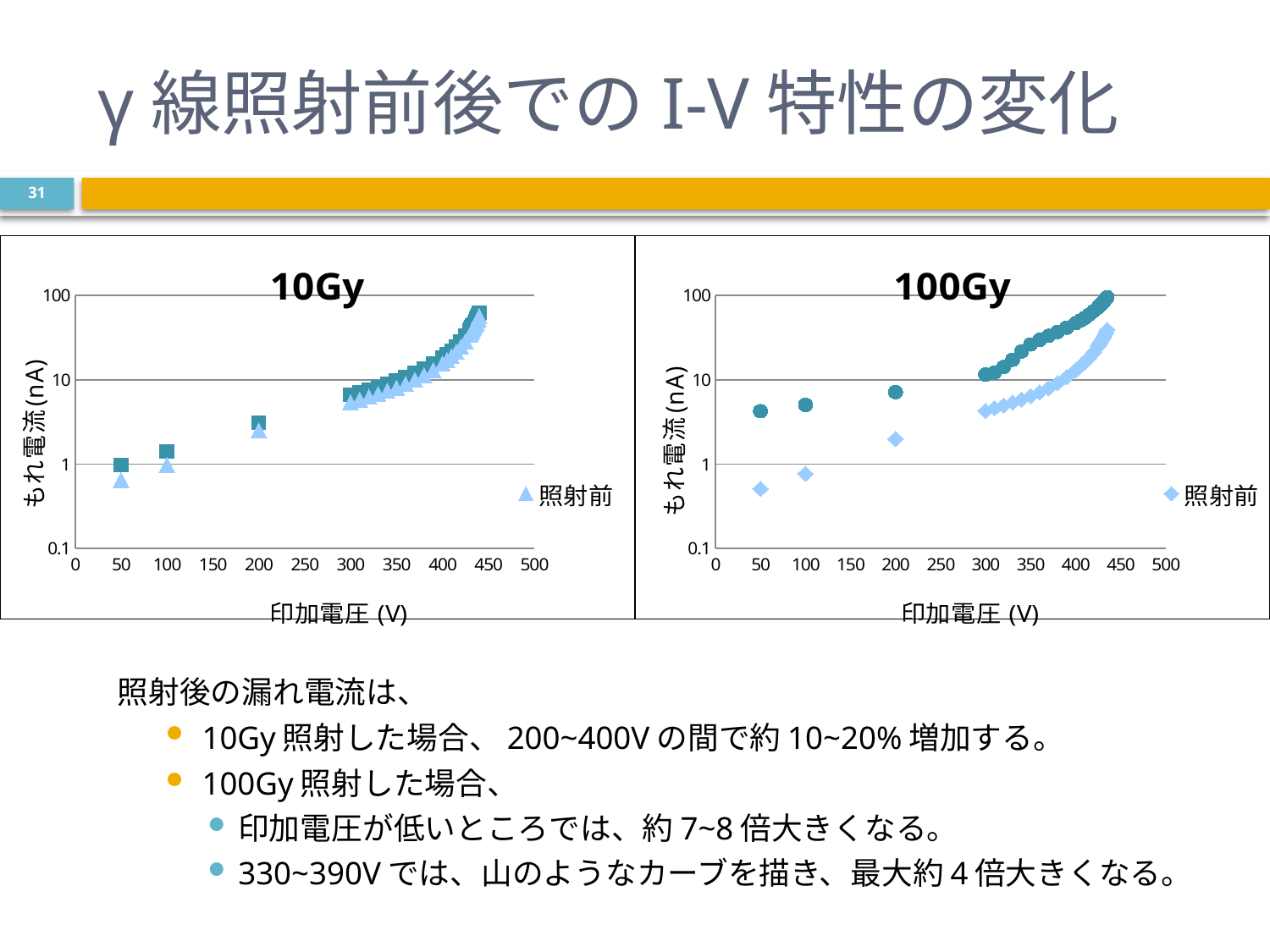
What is the y-axis label of the 10Gy chart? もれ電流 (nA) In the 10Gy chart, is the 照射前 value at 440 V greater or less than 10? greater In the 10Gy chart, is the 照射前 value at 50 V greater or less than 1? less In the 10Gy chart, is the 照射前 value at 300 V greater or less than 10? less In the 100Gy chart, do the 照射前 values rise or fall as the applied voltage increases from 50 V to 450 V? rise What is the title of the chart on the right? 100Gy What kind of chart is the 10Gy chart on the left? scatter chart In the 100Gy chart, at 50 V, which series has the higher value: the 照射前 series or the dark teal circle series? the dark teal circle series